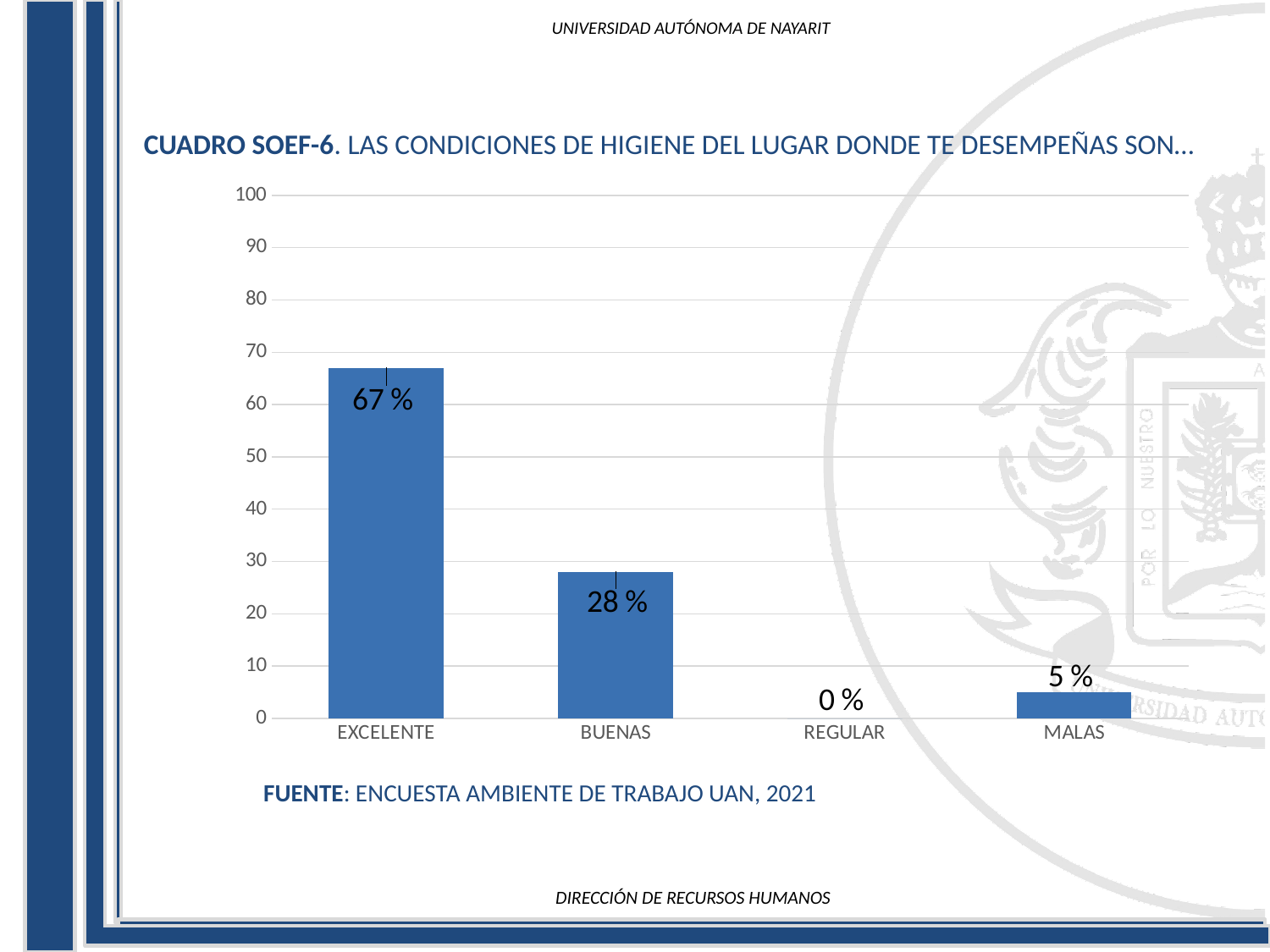
Which category has the highest value? EXCELENTE How many categories are shown on the x axis? 4 What is the value for BUENAS? 28 % What is the source cited below the chart? ENCUESTA AMBIENTE DE TRABAJO UAN, 2021 Which category has the lowest value? REGULAR Which is larger, the value for BUENAS or the value for MALAS? BUENAS What kind of chart is shown on the slide? bar chart What is the value for EXCELENTE? 67 % What is the value for REGULAR? 0 % What is the difference between the values for EXCELENTE and BUENAS? 39 % What is the value for MALAS? 5 % Is the value for EXCELENTE greater or less than 60? greater